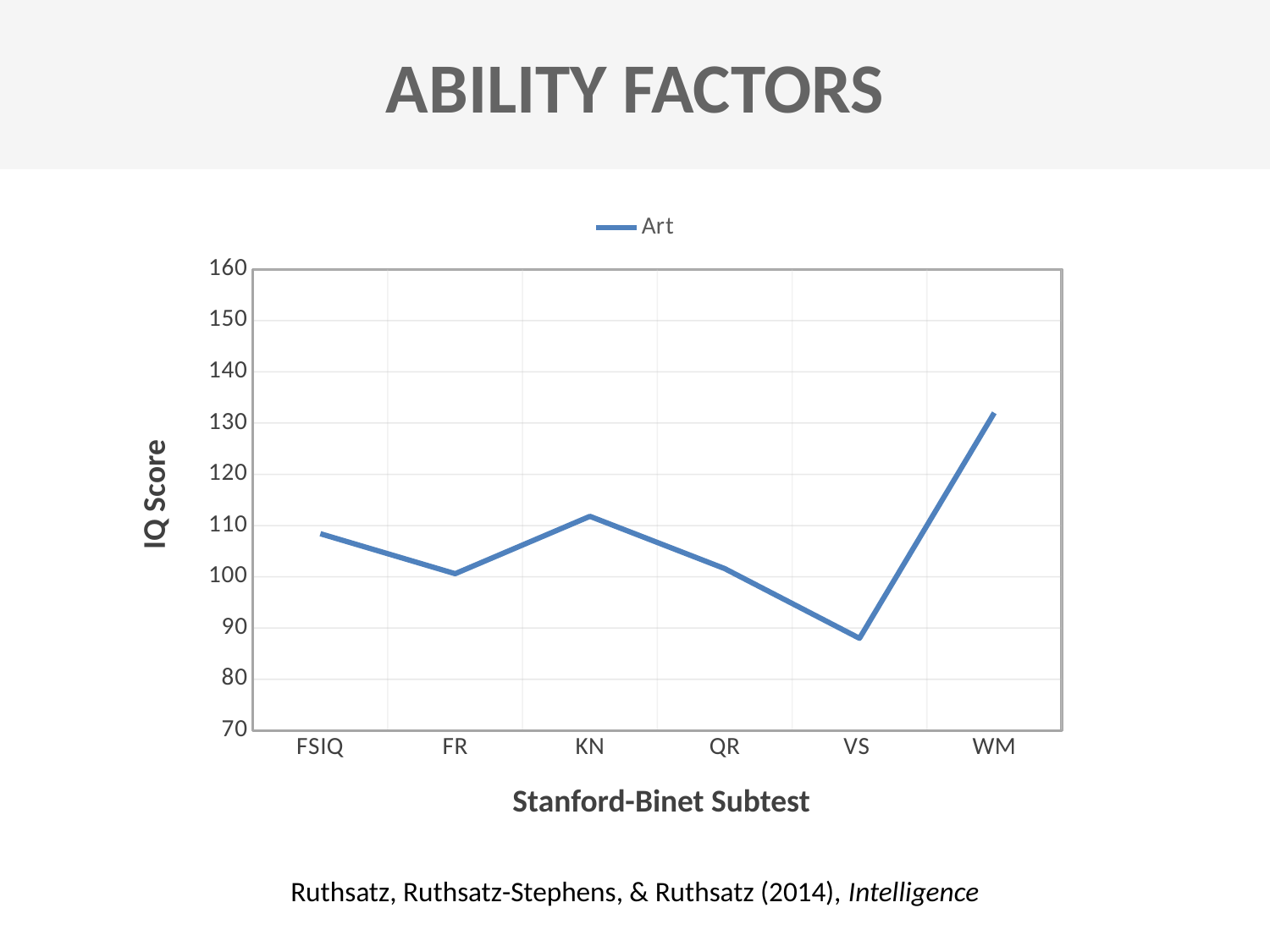
Which subtest has the highest IQ score for the Art series? WM Is the IQ score for WM greater or less than 120? greater Which has the higher IQ score, KN or QR? KN Is the IQ score for VS greater or less than 100? less Which has the higher IQ score, FSIQ or FR? FSIQ Which subtest has the lowest IQ score for the Art series? VS Is the IQ score for FSIQ greater or less than 100? greater What is the name of the series shown in the legend? Art How many Stanford-Binet subtests are plotted along the x axis? 6 How many series does the legend list? 1 What kind of chart is shown on the slide? line chart Does the IQ score rise or fall from QR to VS? fall